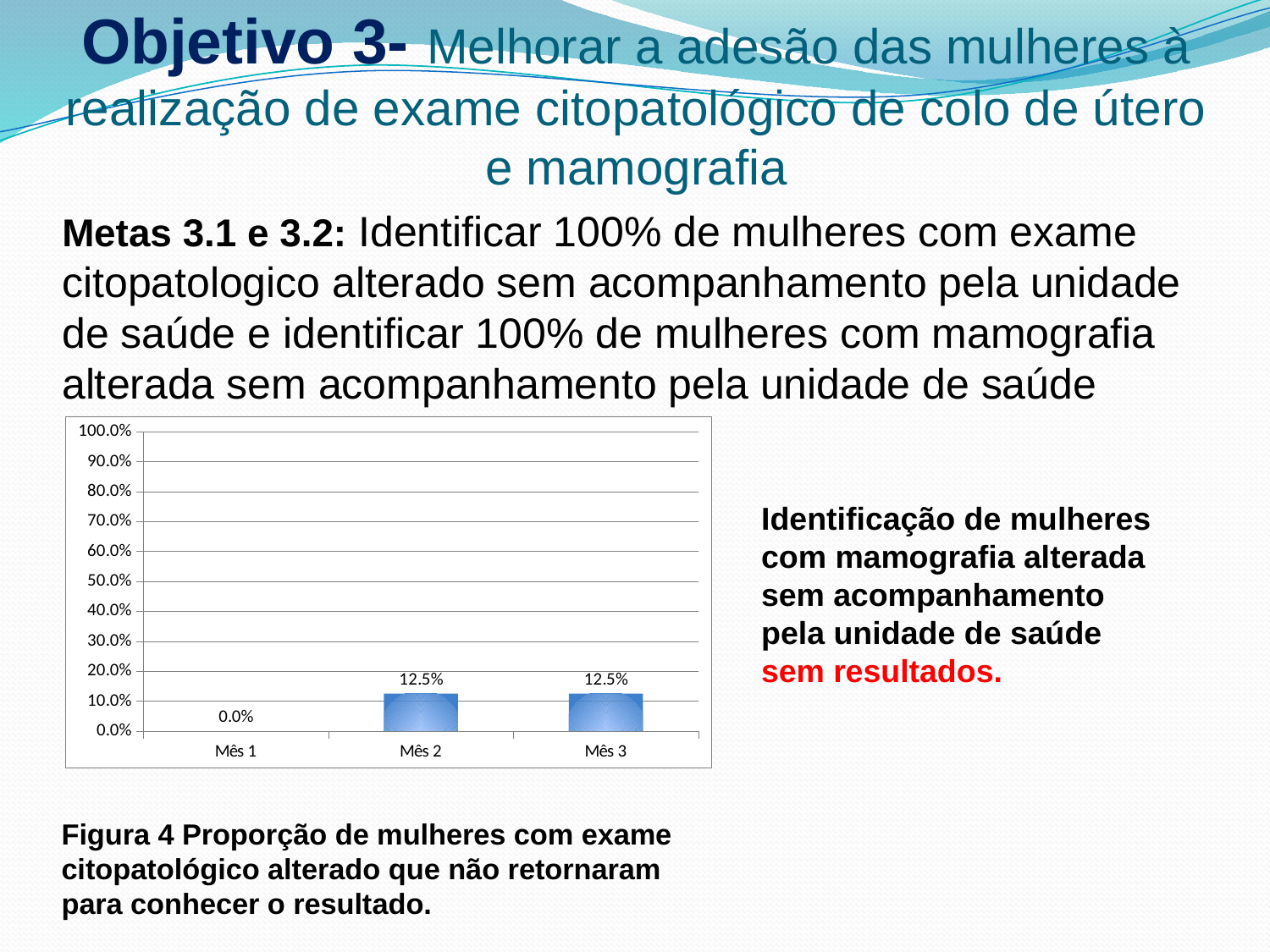
Which month has the lowest value? Mês 1 What is the value for Mês 1? 0.0% What is the difference between the values for Mês 2 and Mês 1? 12.5% Which is larger, the value for Mês 1 or the value for Mês 3? Mês 3 How many months are shown on the x axis? 3 What is the highest value shown on the y axis? 100.0% What is the figure number given in the caption below the chart? Figura 4 Does the value rise or fall from Mês 1 to Mês 2? rise Is the value for Mês 2 greater or less than 20.0%? less What kind of chart is shown on the slide? bar chart What is the value for Mês 2? 12.5% What is the value for Mês 3? 12.5%